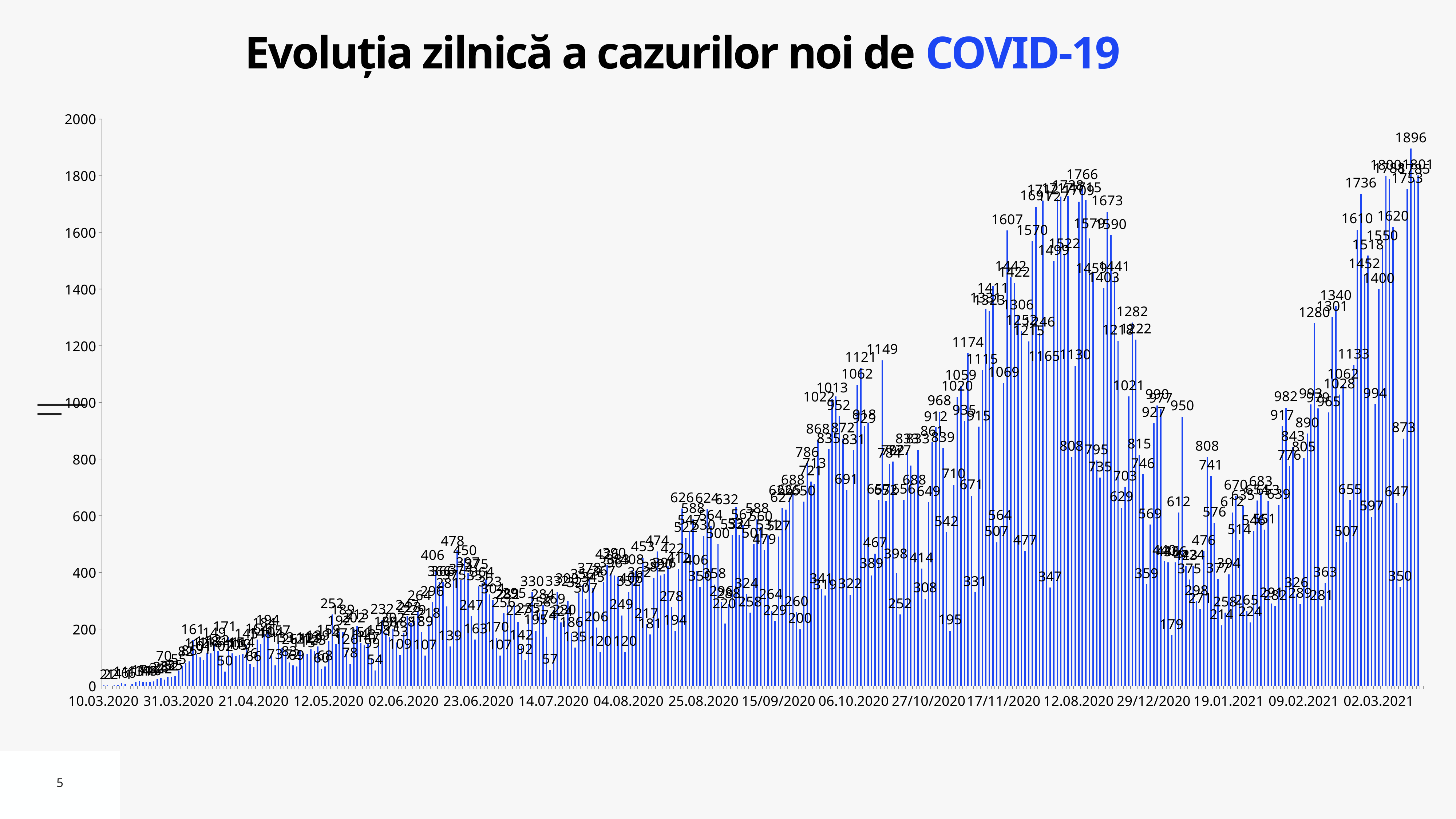
By how much does the overall maximum of 1896 exceed the 1766 peak of the late-2020 wave? 130 What is the highest value shown on the vertical axis? 2000 Which is larger, the 1766 peak of the late-2020 wave or the 1896 peak at the end of the chart? 1896 Are the bars around 31.03.2020 greater or less than 400? less Overall, do the daily values rise or fall from 10.03.2020 to the end of the chart? rise Is the value for the first bar, at 10.03.2020, greater or less than 200? less What kind of chart is shown on the slide? bar chart What is the first date label on the x axis? 10.03.2020 What is the highest value labeled on the chart? 1896 What is the title of the chart? Evoluția zilnică a cazurilor noi de COVID-19 How many date labels are shown on the x axis? 18 Is the highest bar on the chart greater or less than 1800? greater